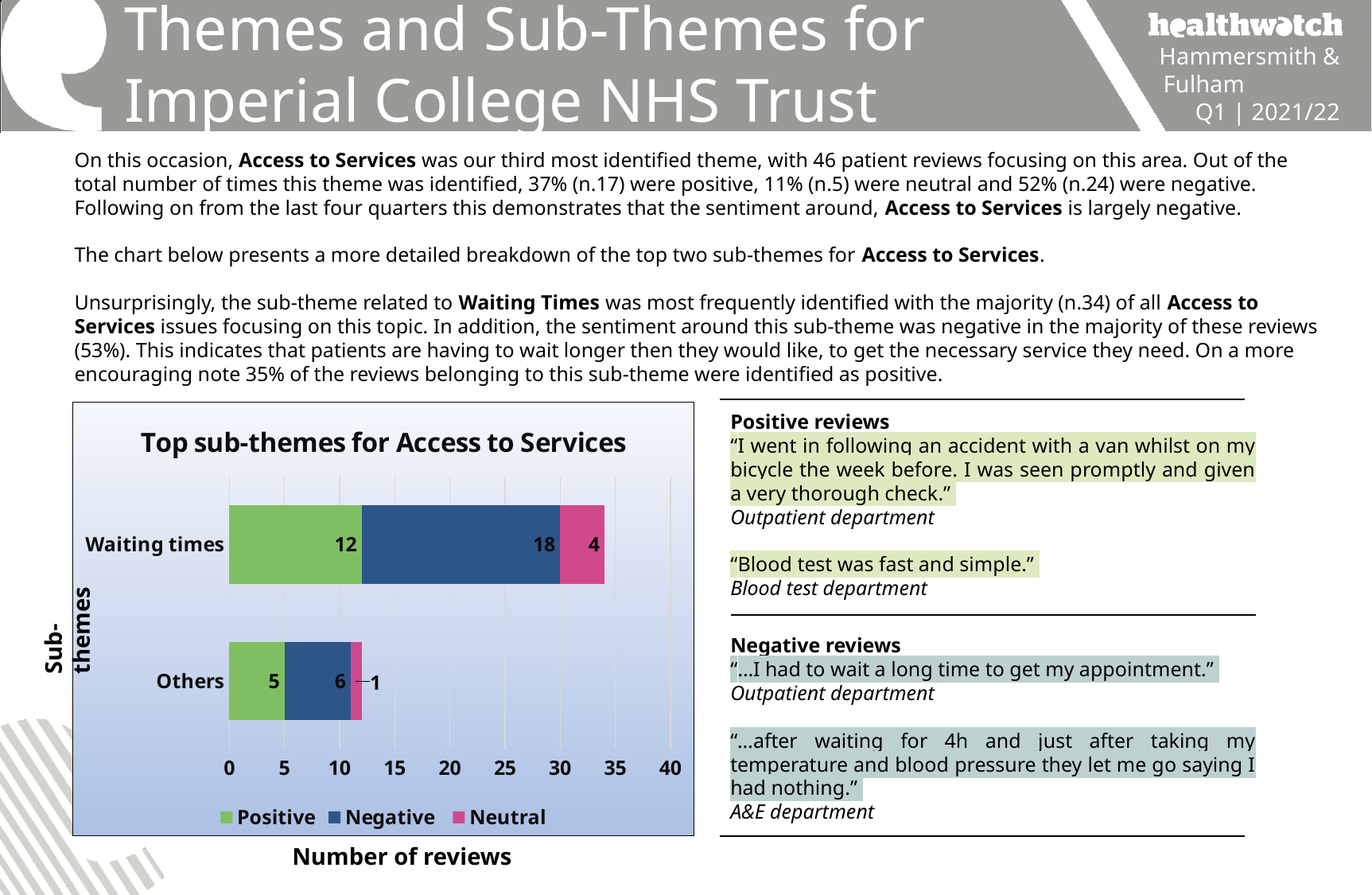
What is the title of the chart? Top sub-themes for Access to Services What is the Negative value for Waiting times? 18 What is the total number of reviews for the Others bar? 12 What kind of chart is shown? Stacked bar chart How many sub-theme categories are shown in the chart? 2 How many series does the legend list? 3 What is the Neutral value for Others? 1 What is the total number of reviews for the Waiting times bar? 34 What is the difference between the Negative and Positive values for Waiting times? 6 What is the Negative value for Others? 6 Which sub-theme has the higher Negative value, Waiting times or Others? Waiting times What is the Positive value for Waiting times? 12